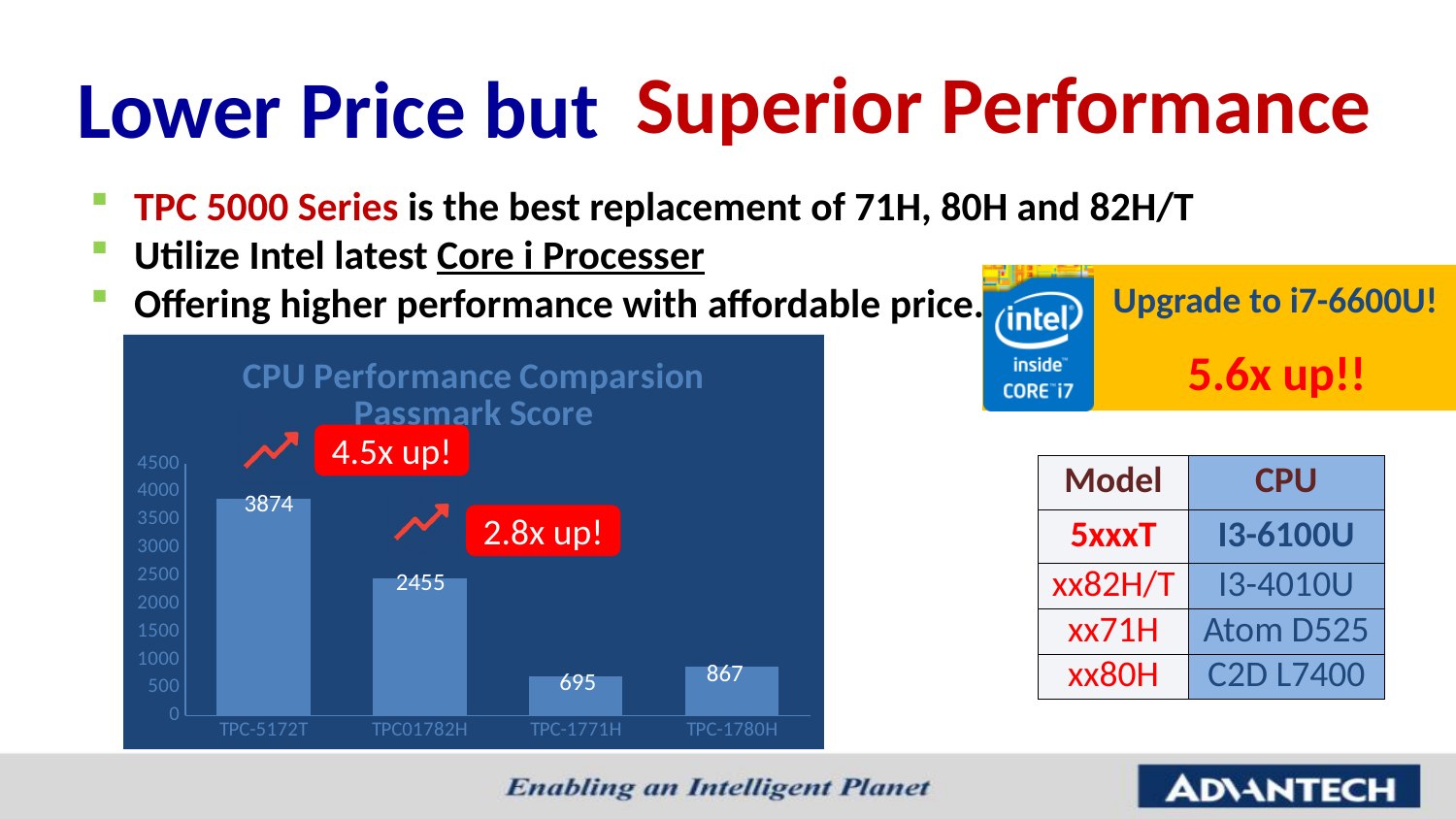
What is the Passmark score for TPC-1771H? 695 What is the difference between the Passmark scores of TPC-1780H and TPC-1771H? 172 Which model has the lowest Passmark score? TPC-1771H What is the difference between the Passmark scores of TPC-5172T and TPC01782H? 1419 Is the Passmark score for TPC01782H greater or less than 2000? greater Which model has the highest Passmark score? TPC-5172T What is the Passmark score for TPC-5172T? 3874 How many models are compared in the chart? 4 What is the Passmark score for TPC-1780H? 867 What type of chart is used to show the CPU performance comparison? Bar chart What is the Passmark score for TPC01782H? 2455 Which has a higher Passmark score, TPC-1780H or TPC-1771H? TPC-1780H